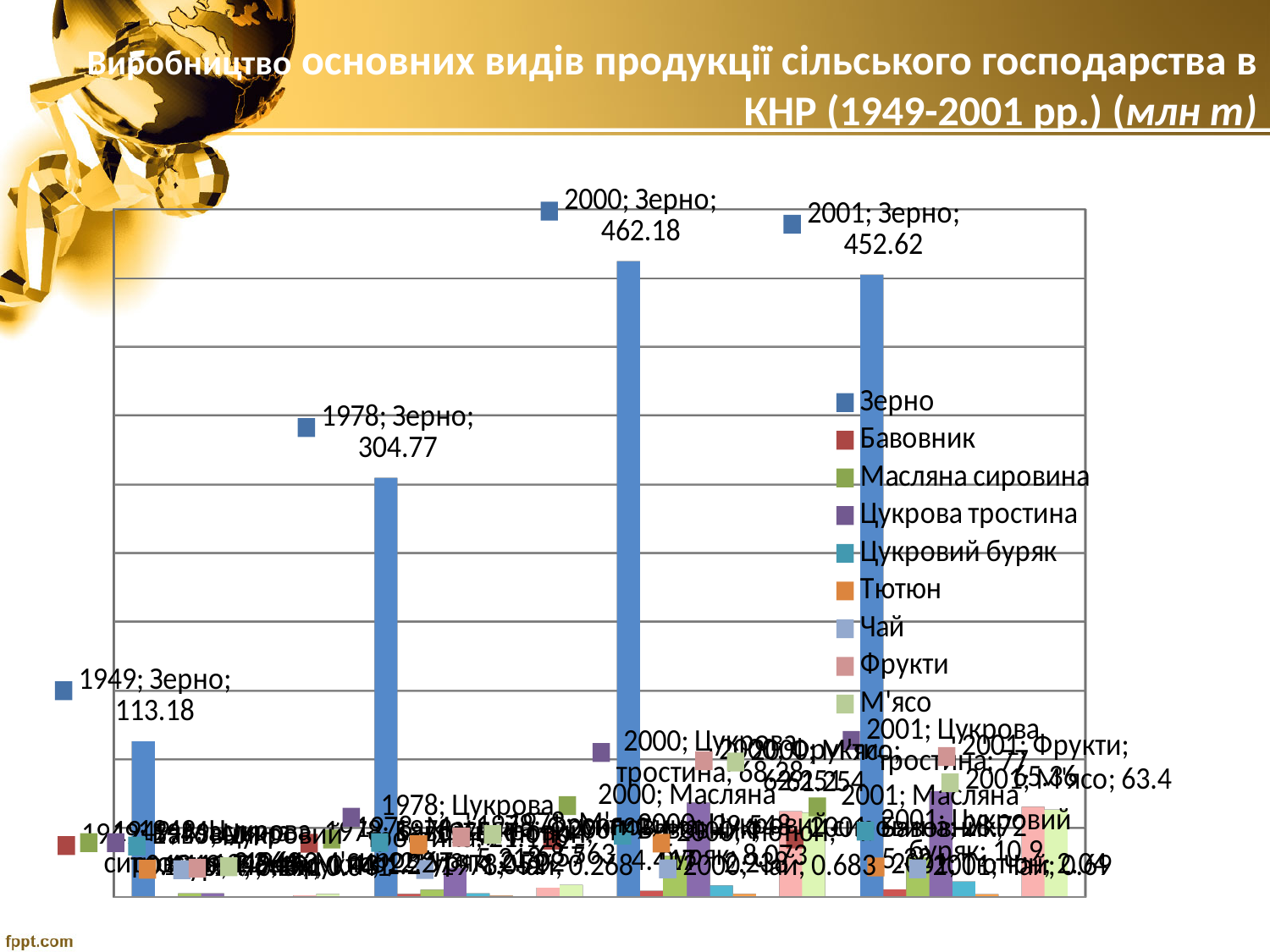
What is the value for Зерно in 1949? 113.18 How many year groups are shown on the x axis? 4 What is the difference between the Зерно values for 2000 and 2001? 9.56 In which year is the value for Зерно the highest? 2000 What is the value for Зерно in 2000? 462.18 How many series does the legend list? 9 In which year is the value for Зерно the lowest? 1949 What is the value for Зерно in 2001? 452.62 What kind of chart is shown on the slide? bar chart What is the difference between the Зерно values for 1978 and 1949? 191.59 Which is larger, the Зерно value for 1978 or for 2001? 2001 What is the value for Зерно in 1978? 304.77